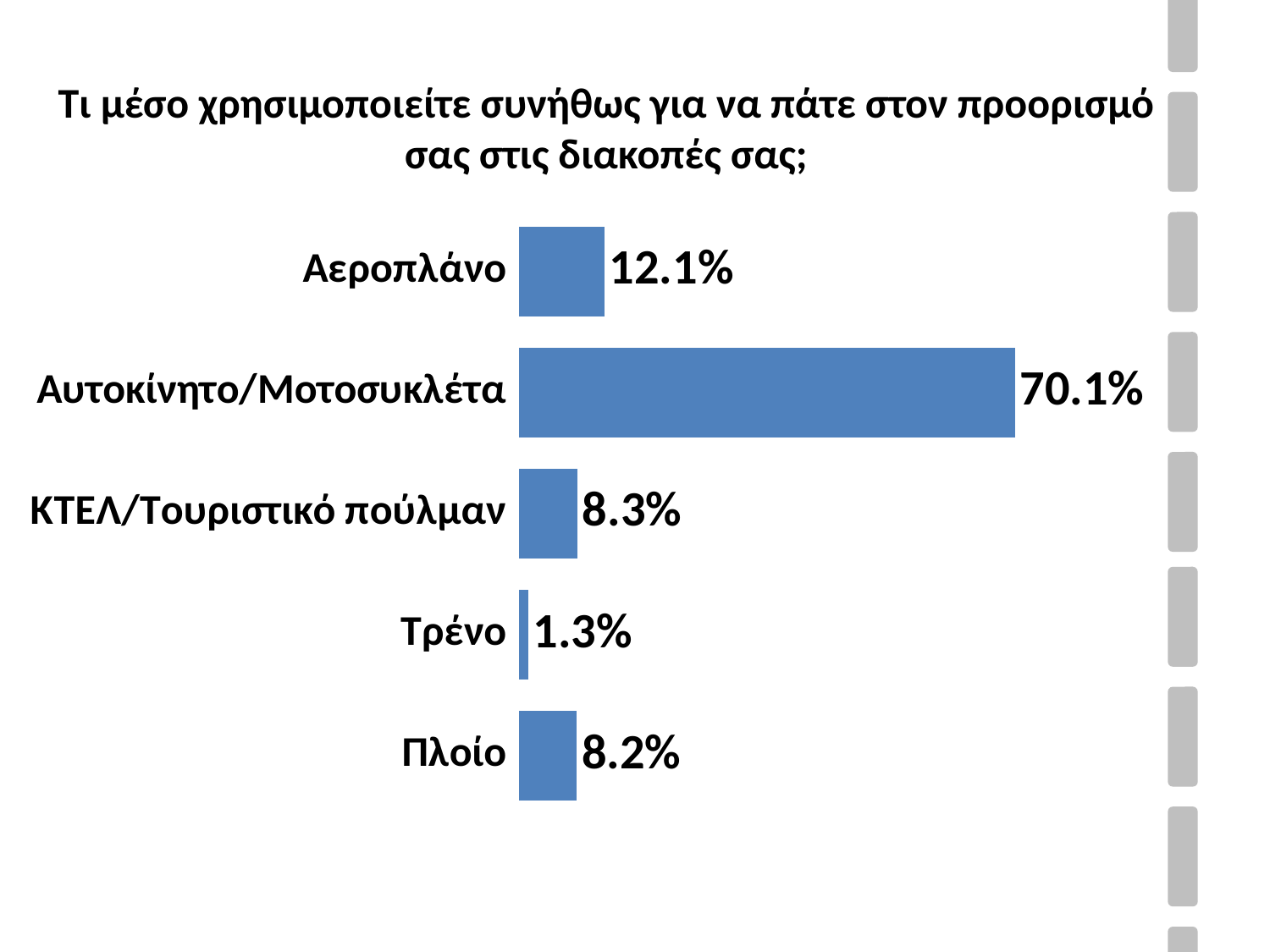
Which is larger, the value for Αεροπλάνο or the value for Πλοίο? Αεροπλάνο What is the value for ΚΤΕΛ/Τουριστικό πούλμαν? 8.3% What is the value for Αυτοκίνητο/Μοτοσυκλέτα? 70.1% What kind of chart is shown on the slide? Bar chart How many categories are shown in the chart? 5 Which category has the highest value? Αυτοκίνητο/Μοτοσυκλέτα What is the title of the chart? Τι μέσο χρησιμοποιείτε συνήθως για να πάτε στον προορισμό σας στις διακοπές σας; What is the value for Πλοίο? 8.2% What is the difference between the values for Αυτοκίνητο/Μοτοσυκλέτα and Αεροπλάνο? 58 percentage points What is the value for Αεροπλάνο? 12.1% What is the value for Τρένο? 1.3% Which category has the lowest value? Τρένο